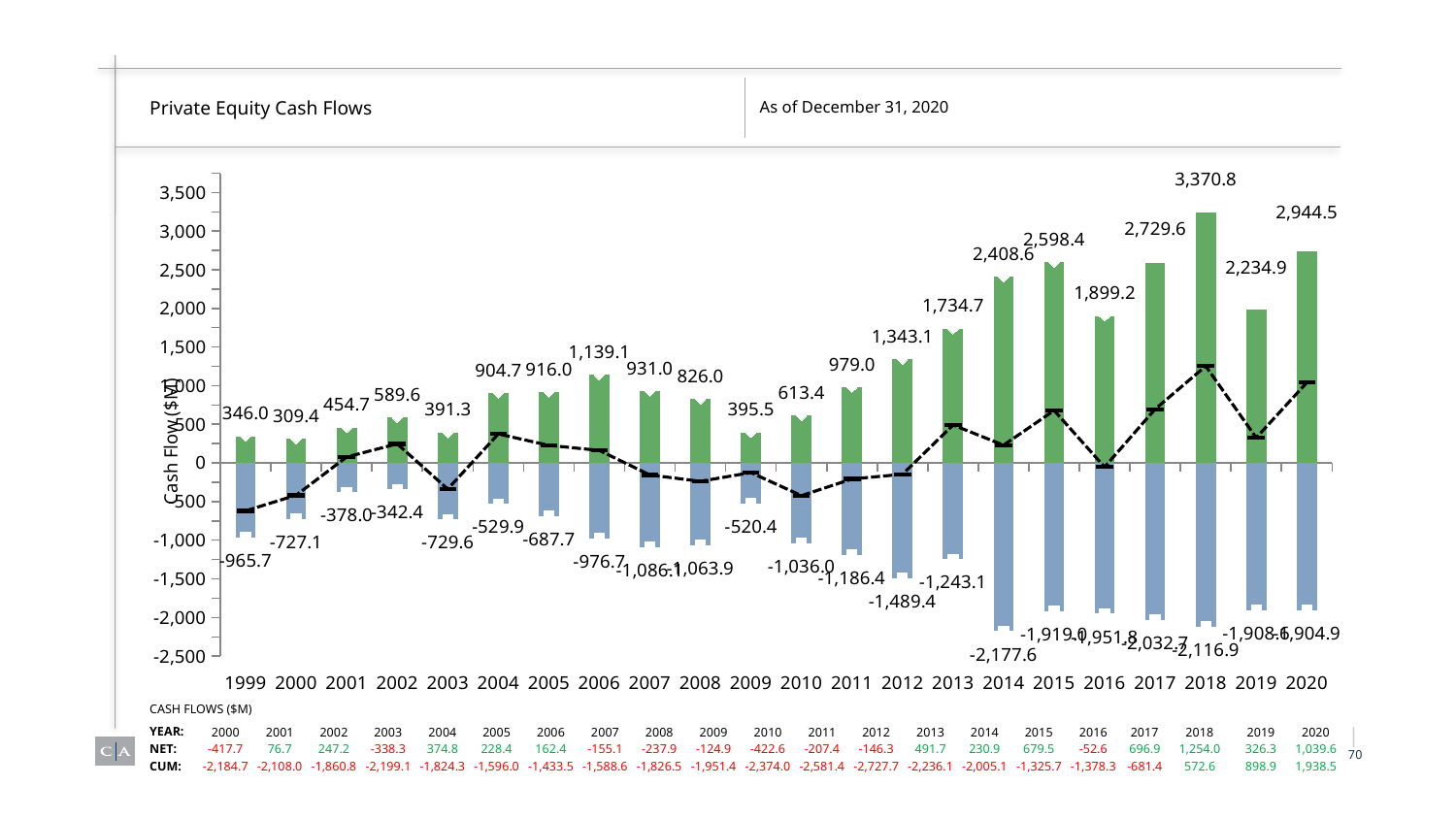
What is the value of the green bar for 2006? 1,139.1 Which year has a larger green bar, 2015 or 2016? 2015 Which year has the lowest (most negative) blue bar? 2014 What is the value of the green bar for 2018? 3,370.8 Is the dashed line value for 2018 greater or less than 1,000? greater Which year has the highest green bar? 2018 What kind of chart is used to show the cash flows? Bar chart with a dashed line What is the title of the chart? Private Equity Cash Flows What is the value of the blue bar for 2014? -2,177.6 Do the green bars rise or fall from 2013 to 2015? Rise What is the difference between the green bar values for 2020 and 2019? 709.6 How many years are shown on the x axis of the chart? 22